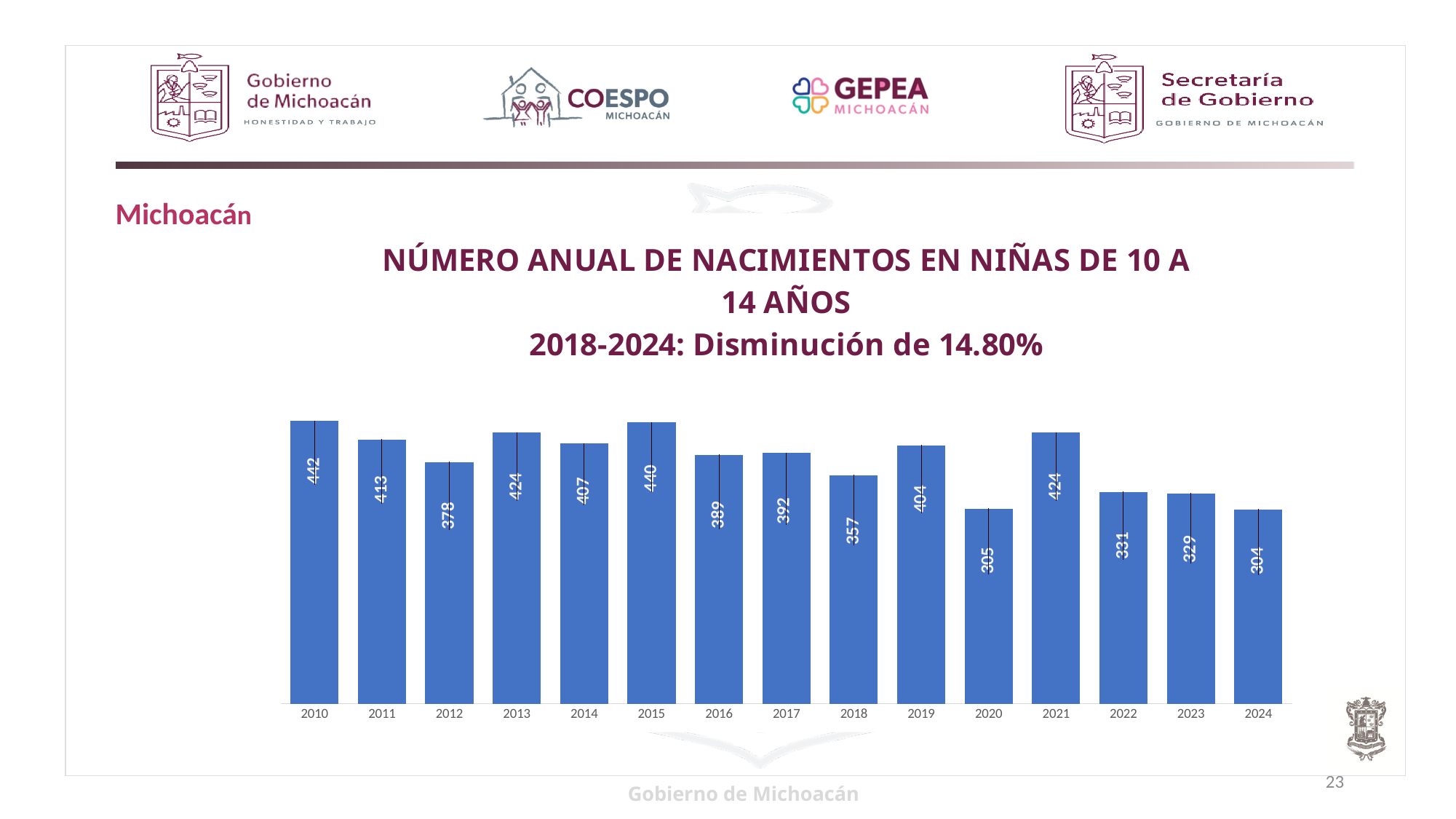
What is the value for 2024? 304 What is the difference between the values for 2010 and 2024? 138 Which is larger, the value for 2012 or the value for 2016? 2016 How many years are shown on the x axis? 15 Do the values generally rise or fall from 2010 to 2024? Fall What is the value for 2018? 357 Which year has the lowest value? 2024 What is the value for 2015? 440 What kind of chart is shown on the slide? Bar chart What is the difference between the values for 2018 and 2024? 53 Which year has the highest value? 2010 What is the value for 2020? 305